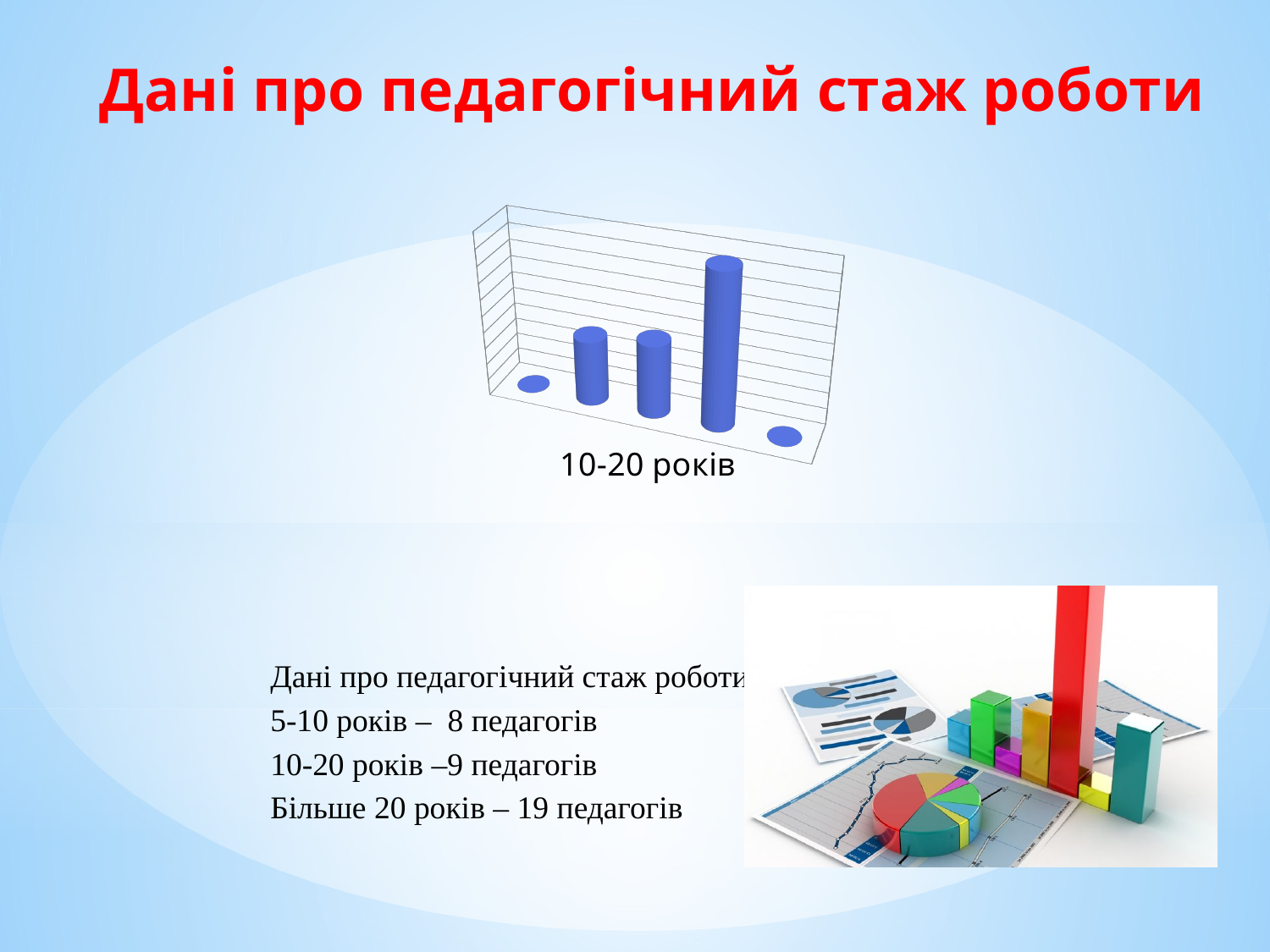
What kind of chart is shown on the slide? bar chart Is the second bar from the left taller or shorter than the fourth bar from the left? shorter How many bars in the chart have a visible height above zero? 3 Which bar in the chart is the tallest? the fourth bar from the left Is the fourth bar from the left taller or shorter than the third bar from the left? taller What is the only category label readable beneath the chart? 10-20 років What colour are the bars in the chart? blue How many bar positions (categories) are plotted in the chart, including the flat ones? 5